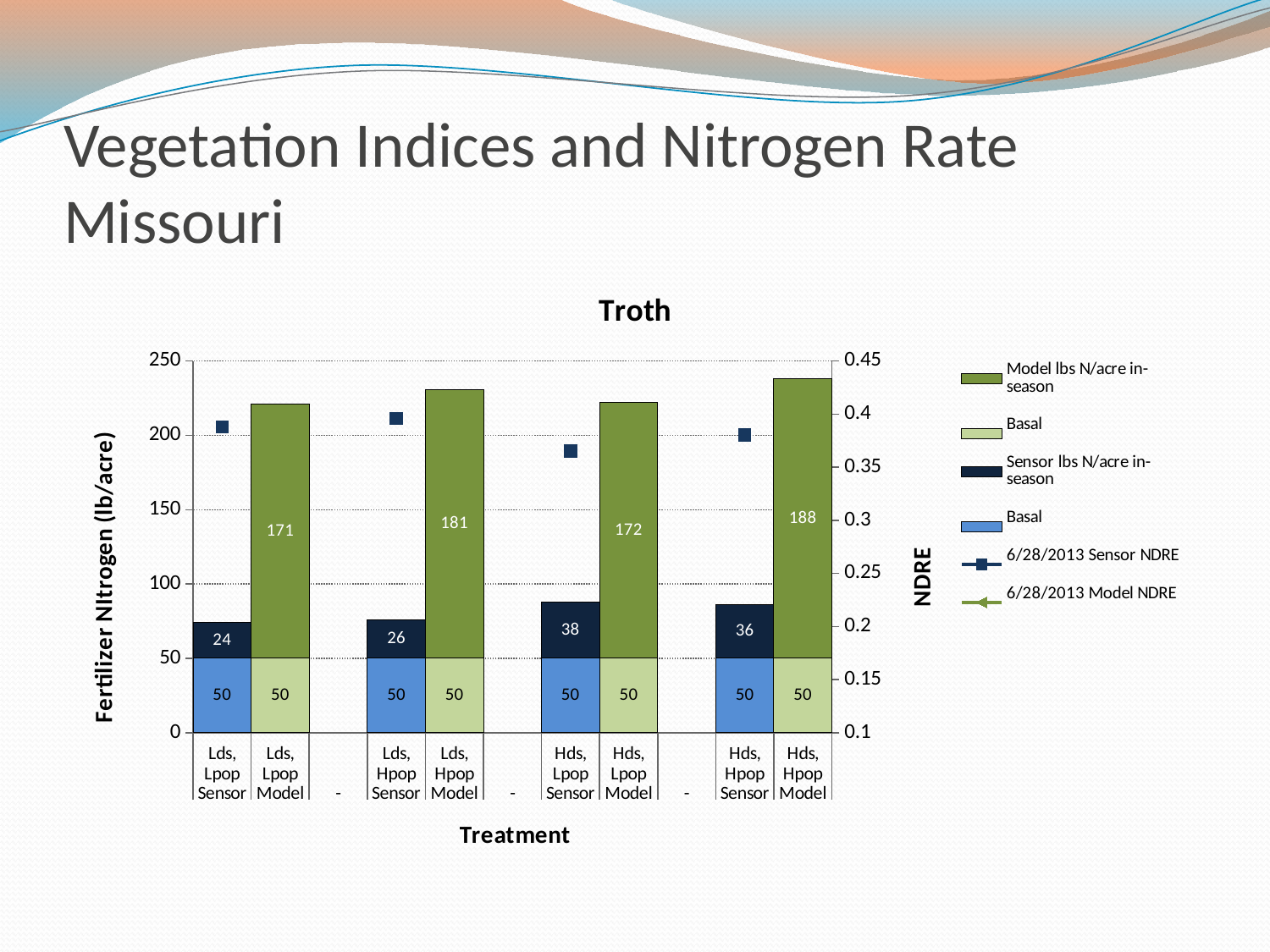
What is the total height of the stacked bar for Hds, Lpop Sensor (Basal plus Sensor in-season)? 88 What is the title of the chart? Troth What is the difference between the Model in-season values for Lds, Hpop Model and Lds, Lpop Model? 10 Which is larger, the Sensor in-season value for Hds, Lpop Sensor or for Hds, Hpop Sensor? Hds, Lpop Sensor What is the Basal value shown for the Hds, Lpop Sensor treatment? 50 What is the total height of the stacked bar for Lds, Hpop Model (Basal plus Model in-season)? 231 What is the Model lbs N/acre in-season value for the Hds, Hpop Model treatment? 188 Which Model treatment has the highest Model lbs N/acre in-season value? Hds, Hpop Model Is the 6/28/2013 Sensor NDRE value for Hds, Lpop Sensor greater or less than 0.35? greater What is the Sensor lbs N/acre in-season value for the Lds, Lpop Sensor treatment? 24 Which Sensor treatment has the lowest Sensor lbs N/acre in-season value? Lds, Lpop Sensor How many entries does the legend list? 6